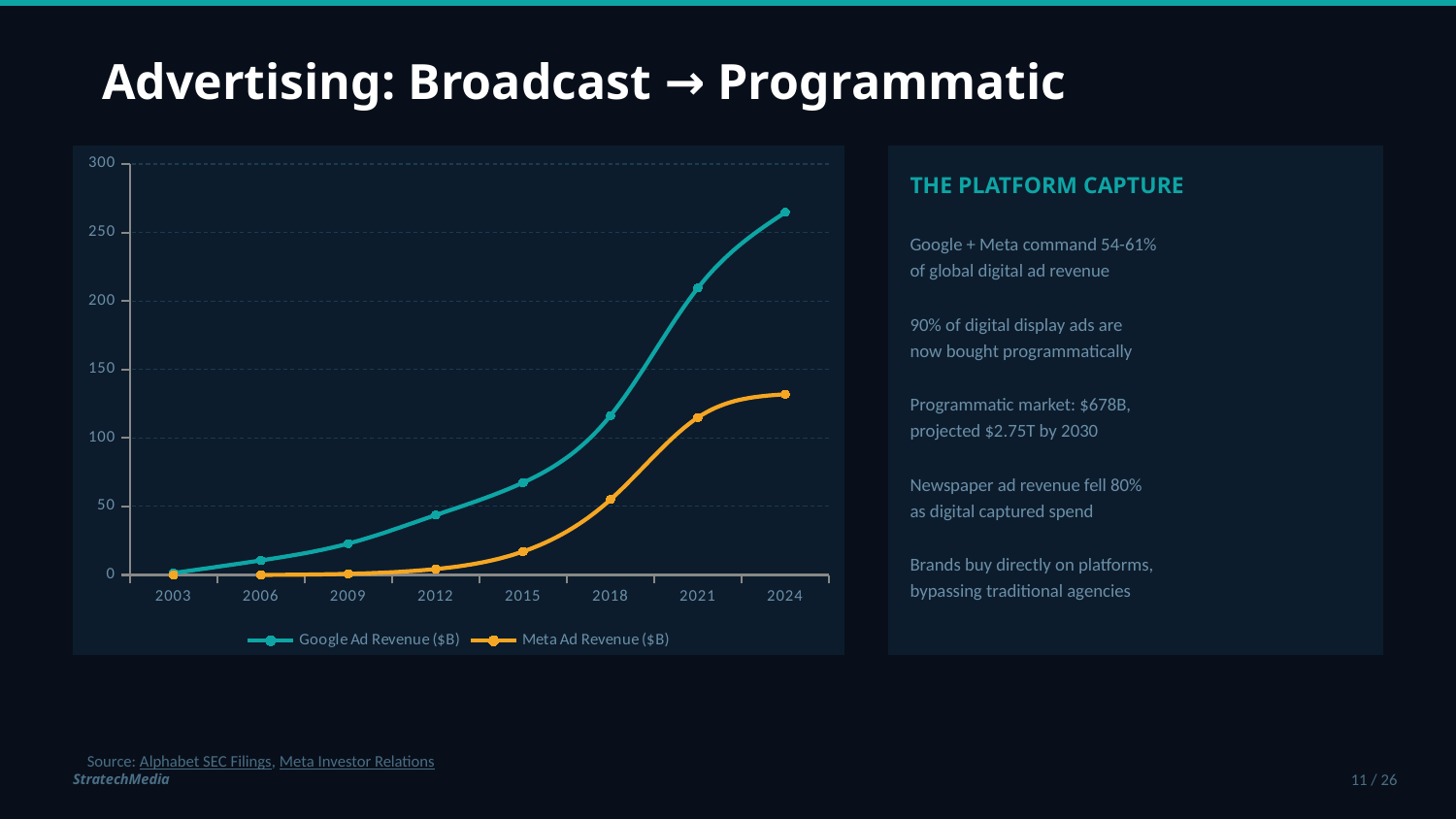
How many series does the chart's legend list? 2 Is the value for Google Ad Revenue in 2021 greater or less than 200? greater Does Google Ad Revenue rise or fall from 2003 to 2024? Rise What is the title of the slide containing the chart? Advertising: Broadcast → Programmatic What kind of chart is shown on the slide? Line chart How many years are marked along the x axis of the chart? 8 In which year does Google Ad Revenue reach its highest value? 2024 Is the value for Google Ad Revenue in 2012 greater or less than 50? less Is the value for Meta Ad Revenue in 2015 greater or less than 50? less In 2024, which series has the larger value, Google Ad Revenue or Meta Ad Revenue? Google Ad Revenue ($B)